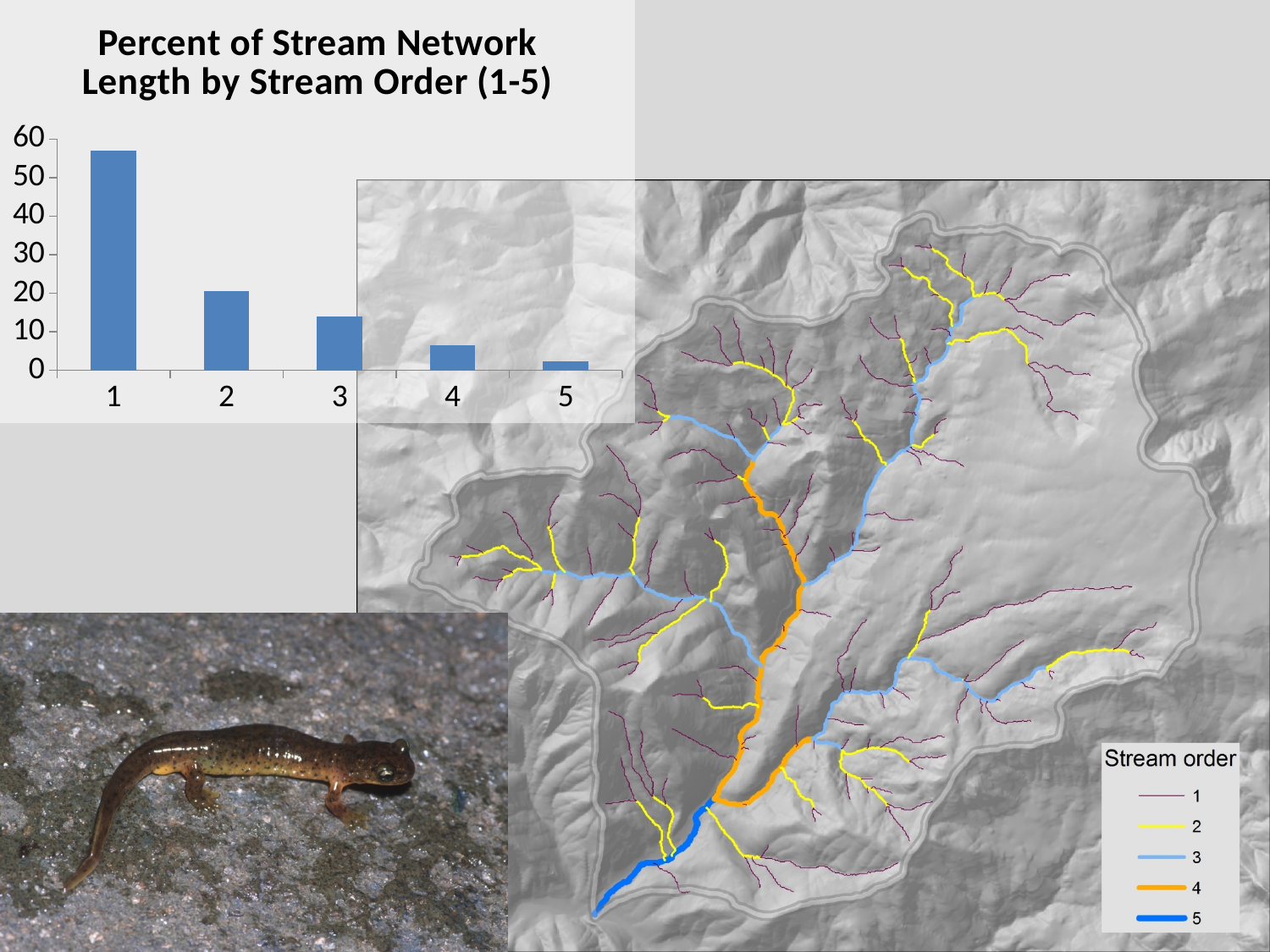
Do the values rise or fall as stream order increases from 1 to 5? fall Which stream order has the highest percent of stream network length? 1 How many stream order categories are plotted on the x axis? 5 Which has a larger percent of stream network length, stream order 2 or stream order 3? 2 What kind of chart is shown on the slide? bar chart What is the title of the chart? Percent of Stream Network Length by Stream Order (1-5) Is the value for stream order 3 greater or less than 10? greater Is the value for stream order 2 greater or less than 30? less Which stream order has the lowest percent of stream network length? 5 Is the value for stream order 1 greater or less than 50? greater